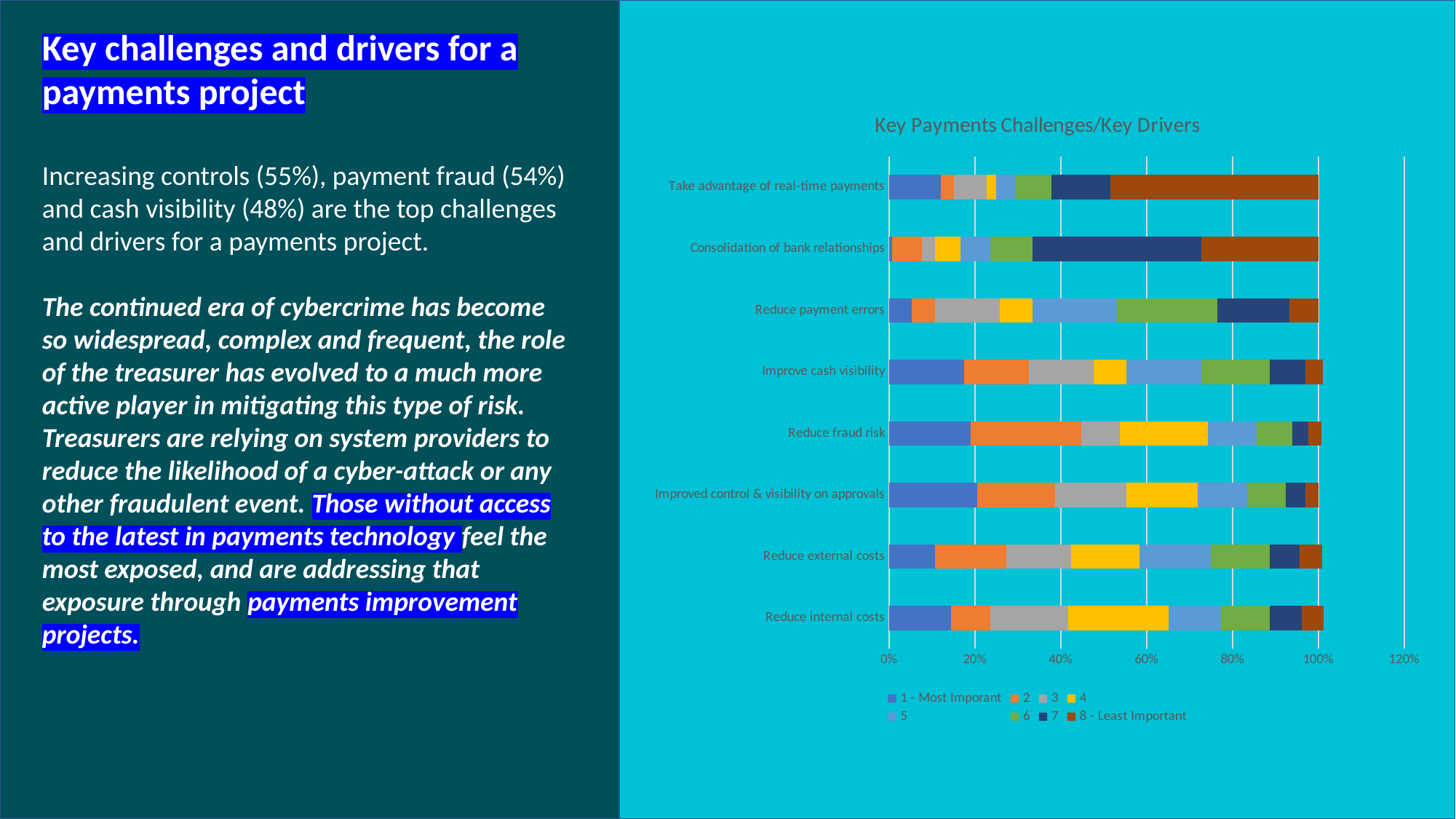
Which category shows no visible '1 - Most Important' segment? Consolidation of bank relationships What is the label of the first series in the legend? 1 - Most Imporant Which category has the largest '8 - Least Important' segment? Take advantage of real-time payments What is the title of the chart? Key Payments Challenges/Key Drivers What is the highest tick value shown on the x axis? 120% Is the '4' segment larger for 'Reduce internal costs' or for 'Take advantage of real-time payments'? Reduce internal costs Is the '8 - Least Important' segment larger for 'Take advantage of real-time payments' or for 'Reduce fraud risk'? Take advantage of real-time payments Is the '7' segment larger for 'Consolidation of bank relationships' or for 'Reduce internal costs'? Consolidation of bank relationships What kind of chart is shown on the slide? Stacked bar chart How many series does the legend list? 8 How many categories are plotted on the chart? 8